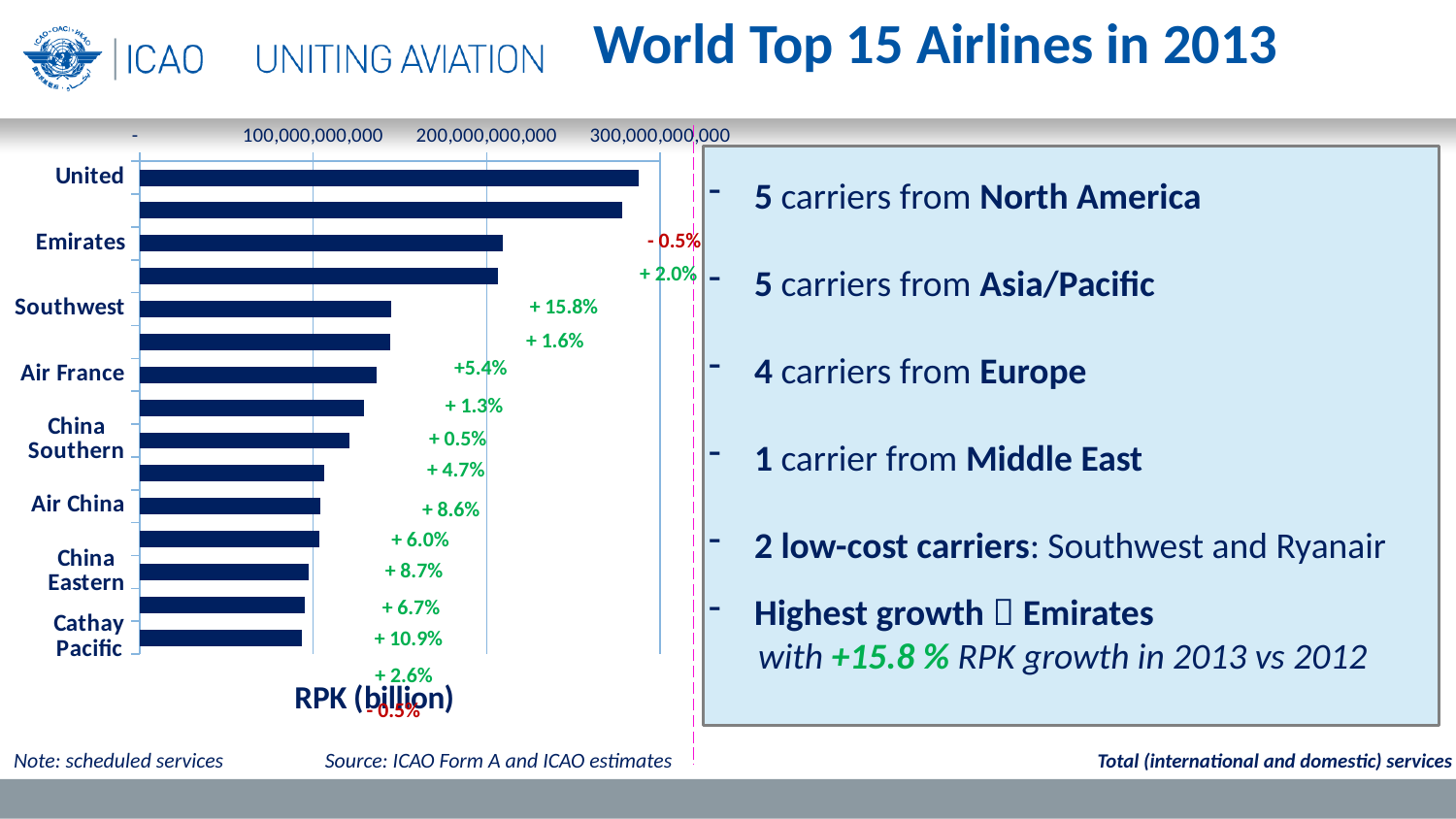
Which has the larger value, Southwest or Air France? Southwest Is the value for Southwest greater or less than 200,000,000,000? less What kind of chart is shown on the slide? bar chart Is the value for Air France greater or less than 100,000,000,000? greater Which has the larger value, United or Emirates? United Do the bar values rise or fall going from the top of the chart to the bottom? fall Which airline has the longest bar in the chart? United Is the value for United greater or less than 200,000,000,000? greater What label is shown beneath the chart's bars? RPK (billion) What is the title of the slide's chart? World Top 15 Airlines in 2013 How many bars are plotted in the chart? 15